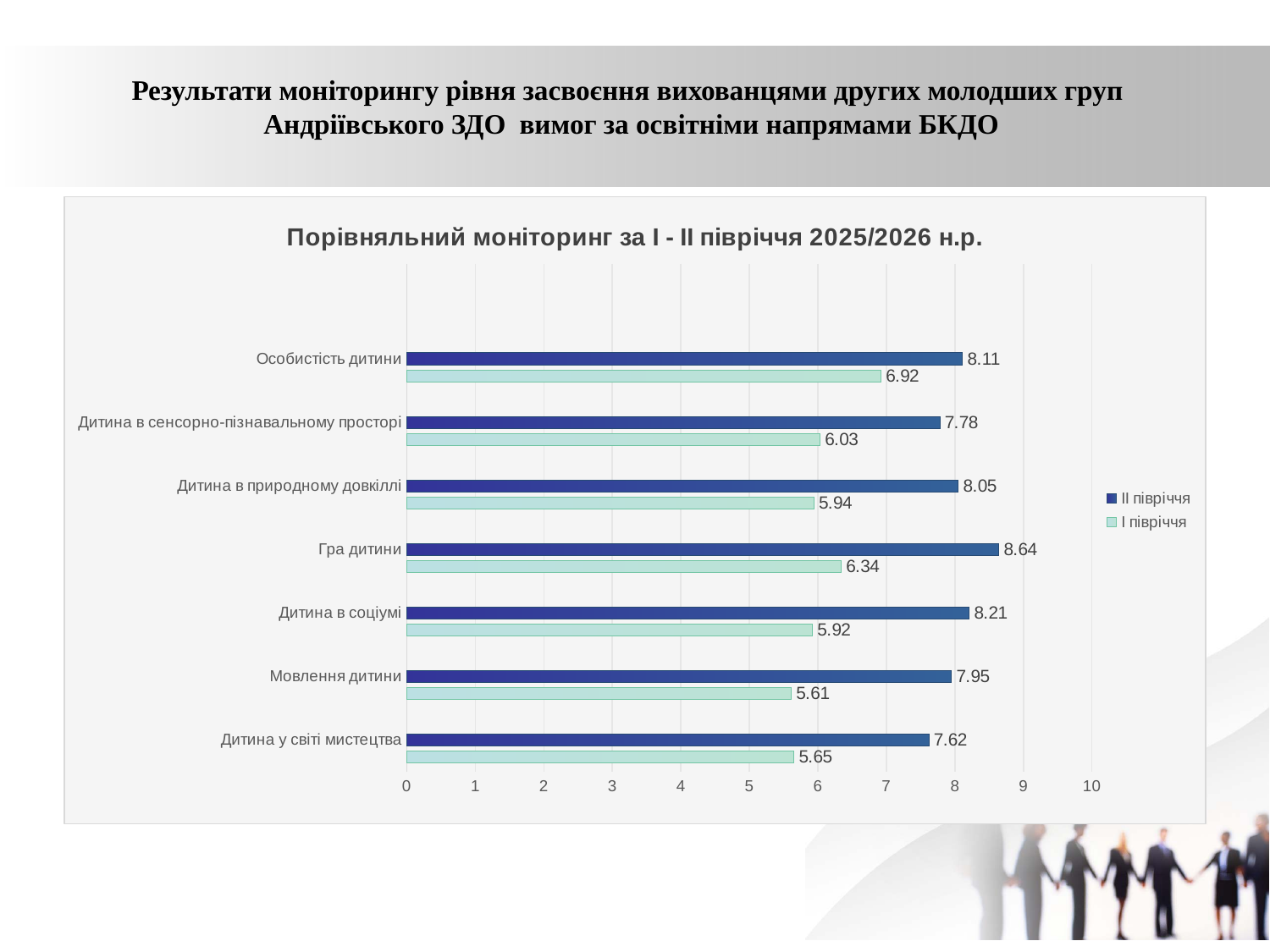
What is the difference between the ІІ півріччя and І півріччя values for Гра дитини? 2.30 Which category has the highest value in the ІІ півріччя series? Гра дитини How many categories are shown on the chart? 7 What kind of chart is shown on the slide? bar chart What is the value for Дитина в сенсорно-пізнавальному просторі in the І півріччя series? 6.03 What is the value for Гра дитини in the ІІ півріччя series? 8.64 Is the ІІ півріччя value for Дитина у світі мистецтва greater or less than 8? less Which is larger: the І півріччя value for Особистість дитини or the І півріччя value for Дитина в соціумі? Особистість дитини What is the value for Мовлення дитини in the І півріччя series? 5.61 Which category has the lowest value in the ІІ півріччя series? Дитина у світі мистецтва Which category has the highest value in the І півріччя series? Особистість дитини How many series does the legend list? 2